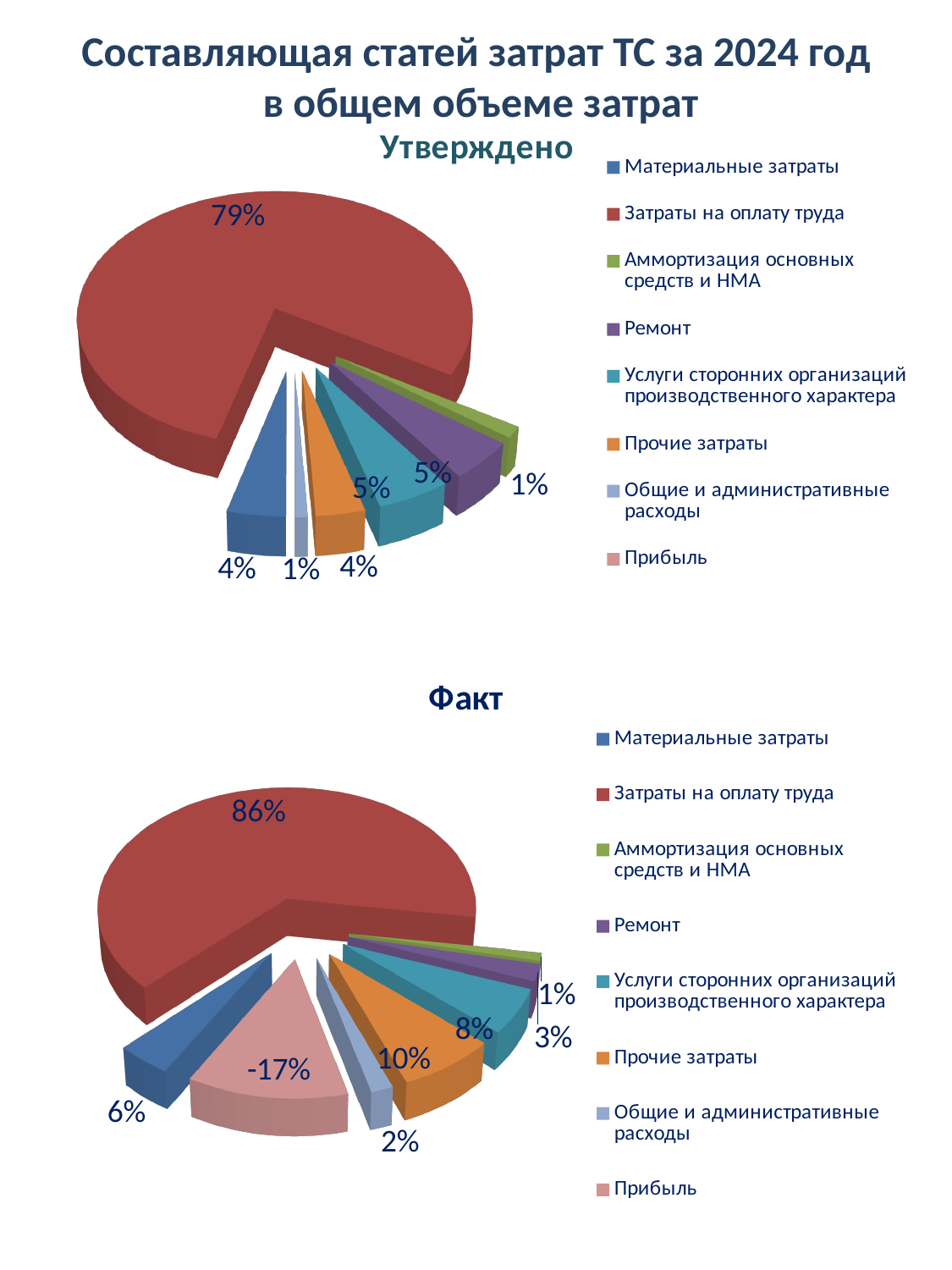
In the 'Факт' pie chart, which is larger: Прочие затраты or Услуги сторонних организаций производственного характера? Прочие затраты In the 'Утверждено' pie chart, which category has the largest share? Затраты на оплату труда In the 'Факт' pie chart, what share is shown for Затраты на оплату труда? 86% In the 'Факт' pie chart, what share is shown for Прочие затраты? 10% In the 'Утверждено' pie chart, what share is shown for Затраты на оплату труда? 79% In the 'Факт' pie chart, what share is shown for Материальные затраты? 6% In the 'Утверждено' pie chart, what share is shown for Материальные затраты? 4% How many entries does the legend of the 'Факт' chart list? 8 What type of chart is the 'Утверждено' chart? Pie chart In the 'Факт' pie chart, what value is shown for Прибыль? -17% In the 'Факт' pie chart, which category has the lowest value? Прибыль What is the difference between the share of Затраты на оплату труда in the 'Факт' chart and in the 'Утверждено' chart? 7%